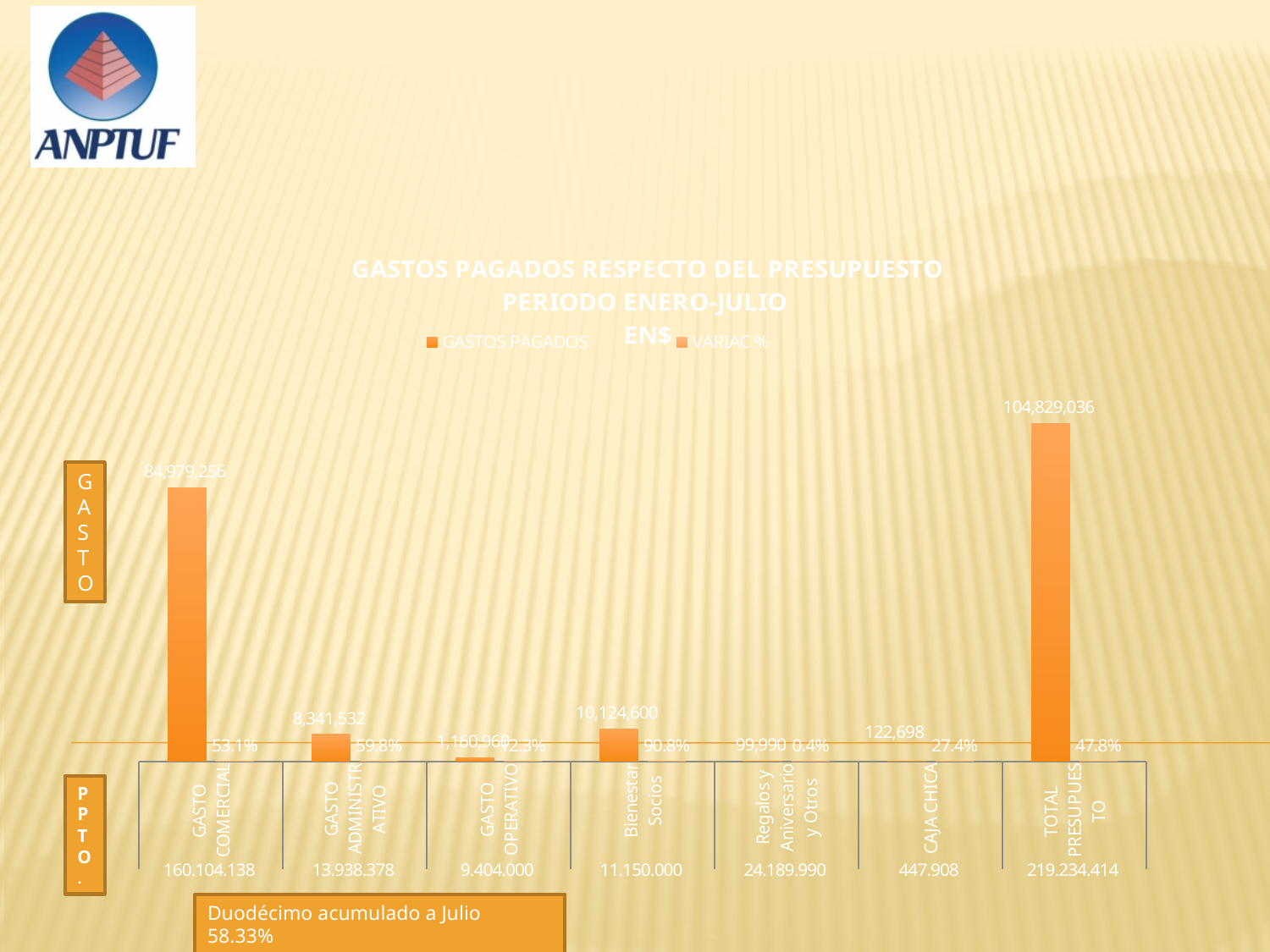
Which category has the highest GASTOS PAGADOS value? TOTAL PRESUPUESTO What is the GASTOS PAGADOS value for GASTO COMERCIAL? 84,979,256 Which has the larger GASTOS PAGADOS value, GASTO ADMINISTRATIVO or Bienestar Socios? Bienestar Socios What is the GASTOS PAGADOS value for TOTAL PRESUPUESTO? 104,829,036 How many series does the chart legend list? 2 How many categories are shown on the x axis of the chart? 7 Which category has the lowest VARIAC % value? Regalos y Aniversario y Otros What is the GASTOS PAGADOS value for CAJA CHICA? 122,698 What is the VARIAC % value for Bienestar Socios? 90.8% What is the difference between the GASTOS PAGADOS values for TOTAL PRESUPUESTO and GASTO COMERCIAL? 19,849,780 Which category has the highest VARIAC % value? Bienestar Socios What kind of chart is shown on the slide? Bar chart